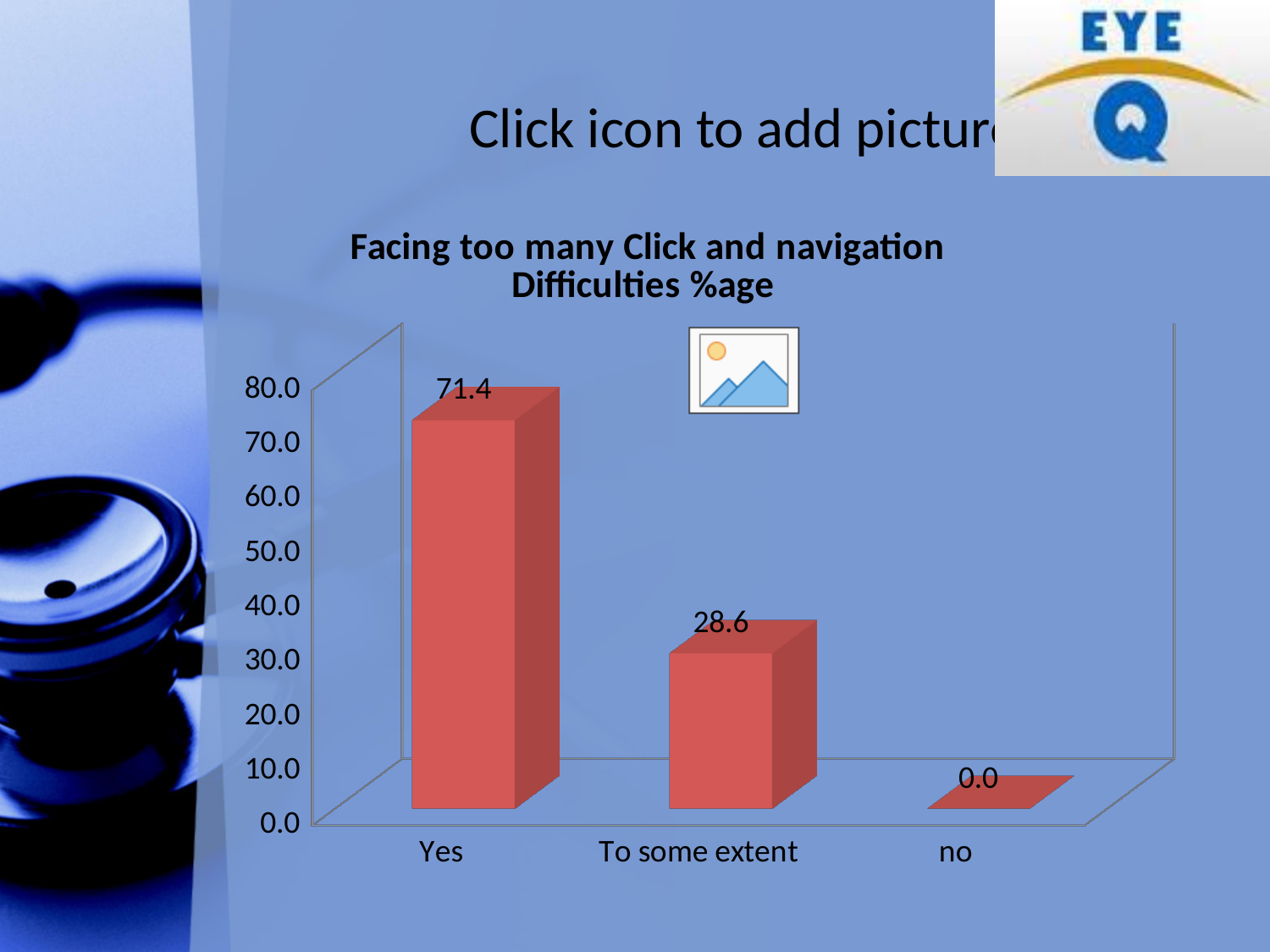
What is the title of the chart? Facing too many Click and navigation Difficulties %age Which category has the lowest value? no What is the value for "no"? 0.0 Do the values rise or fall from left to right along the x axis? fall What is the value for "To some extent"? 28.6 What is the value for "Yes"? 71.4 Which is larger, the value for "Yes" or the value for "To some extent"? Yes What kind of chart is shown on the slide? bar chart How many categories are shown on the x axis? 3 What is the difference between the values for "Yes" and "To some extent"? 42.8 Is the value for "To some extent" greater or less than 40.0? less Which category has the highest value? Yes